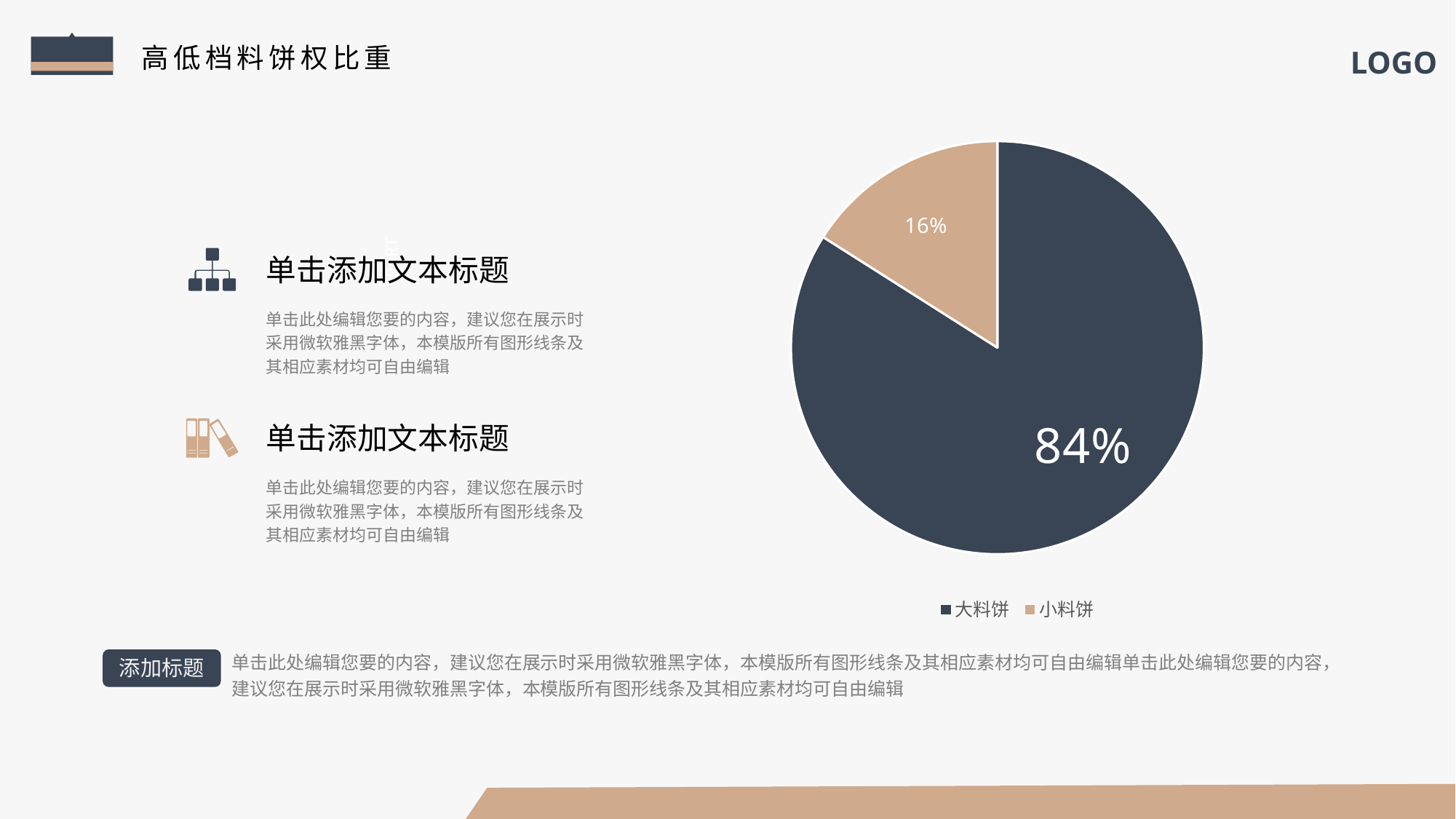
What share of the pie does 小料饼 take? 16% What is the difference between the values for 大料饼 and 小料饼? 68% How many entries does the legend list? 2 Which is larger, the slice for 大料饼 or the slice for 小料饼? 大料饼 What is the value shown for 小料饼? 16% What colour is the slice for 小料饼? tan What kind of chart is shown on the slide? pie chart How many slices does the pie chart have? 2 What is the value shown for 大料饼? 84% What is the title of the slide containing the pie chart? 高低档料饼权比重 Which category has the largest slice of the pie? 大料饼 Which category has the smallest slice of the pie? 小料饼